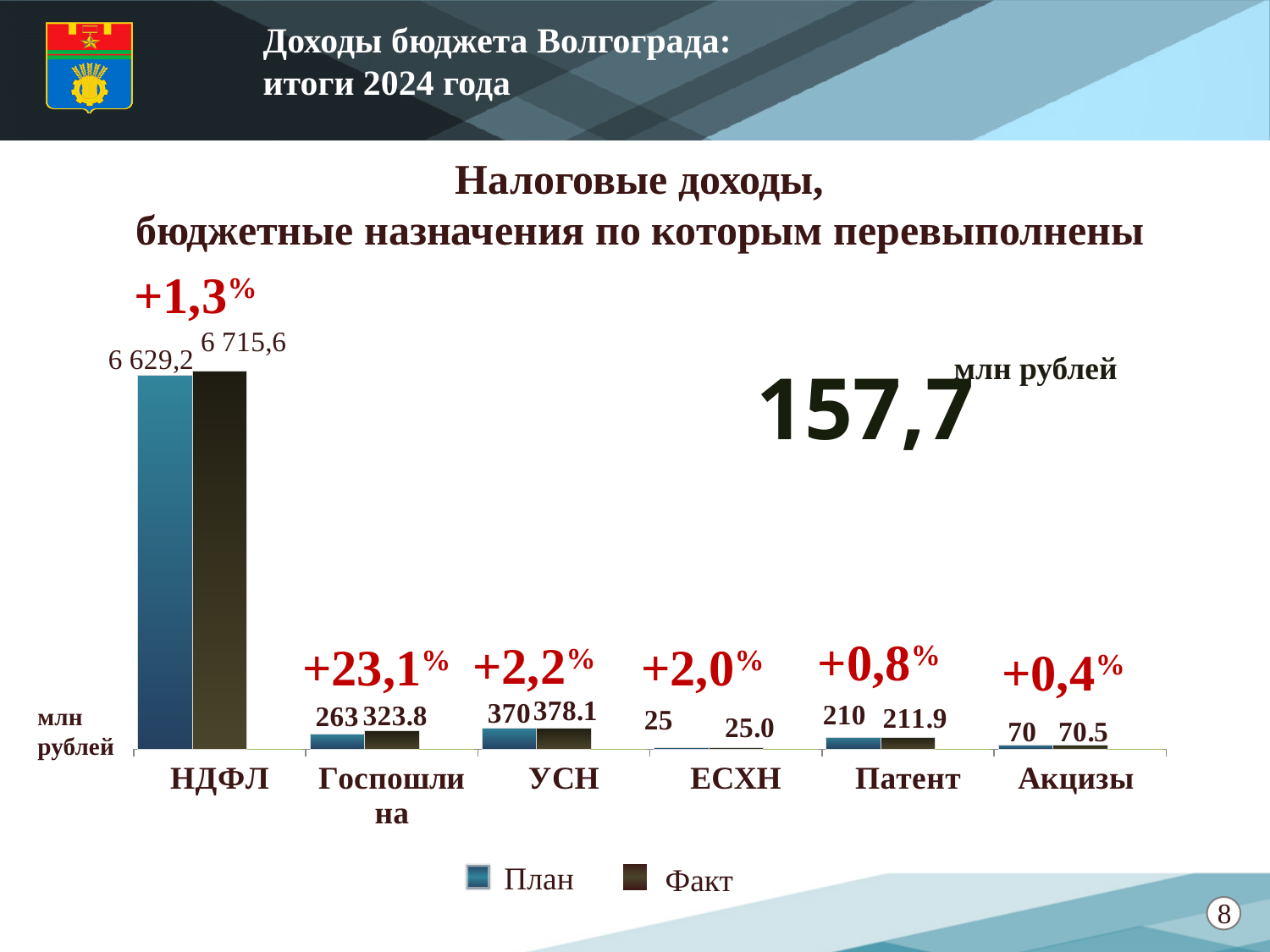
What is the Факт value for УСН? 378.1 What is the План value for НДФЛ? 6 629,2 Which is larger, the Факт value for УСН or the Факт value for Патент? УСН How many series does the legend list? 2 What percentage label is shown above the Госпошлина bars? +23,1% What is the difference between the Факт and План values for Госпошлина? 60.8 What is the Факт value for Госпошлина? 323.8 How many categories are shown on the x axis? 6 Which category has the lowest План value? ЕСХН What kind of chart is shown on the slide? bar chart Which category has the highest Факт value? НДФЛ What is the План value for Патент? 210